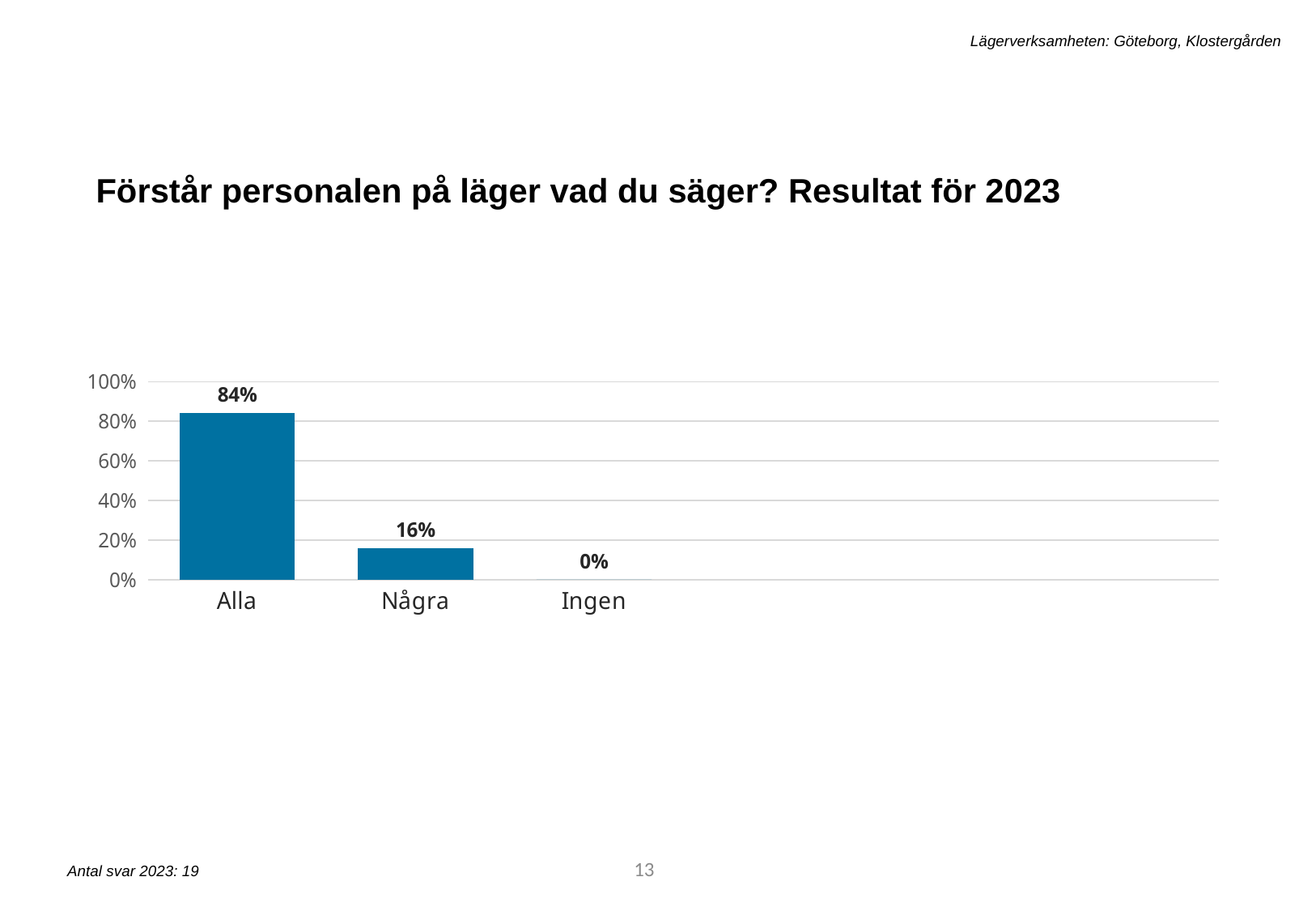
Is the value for Alla greater or less than 60%? greater What is the value for Några? 16% Do the values rise or fall from left to right along the x axis? fall Which is larger, the value for Några or the value for Ingen? Några How many categories are shown on the x axis? 3 What is the title of the chart? Förstår personalen på läger vad du säger? Resultat för 2023 What kind of chart is shown on the slide? bar chart Which category has the lowest value? Ingen What is the value for Ingen? 0% Which category has the highest value? Alla What is the value for Alla? 84% What is the difference between the values for Alla and Några? 68%